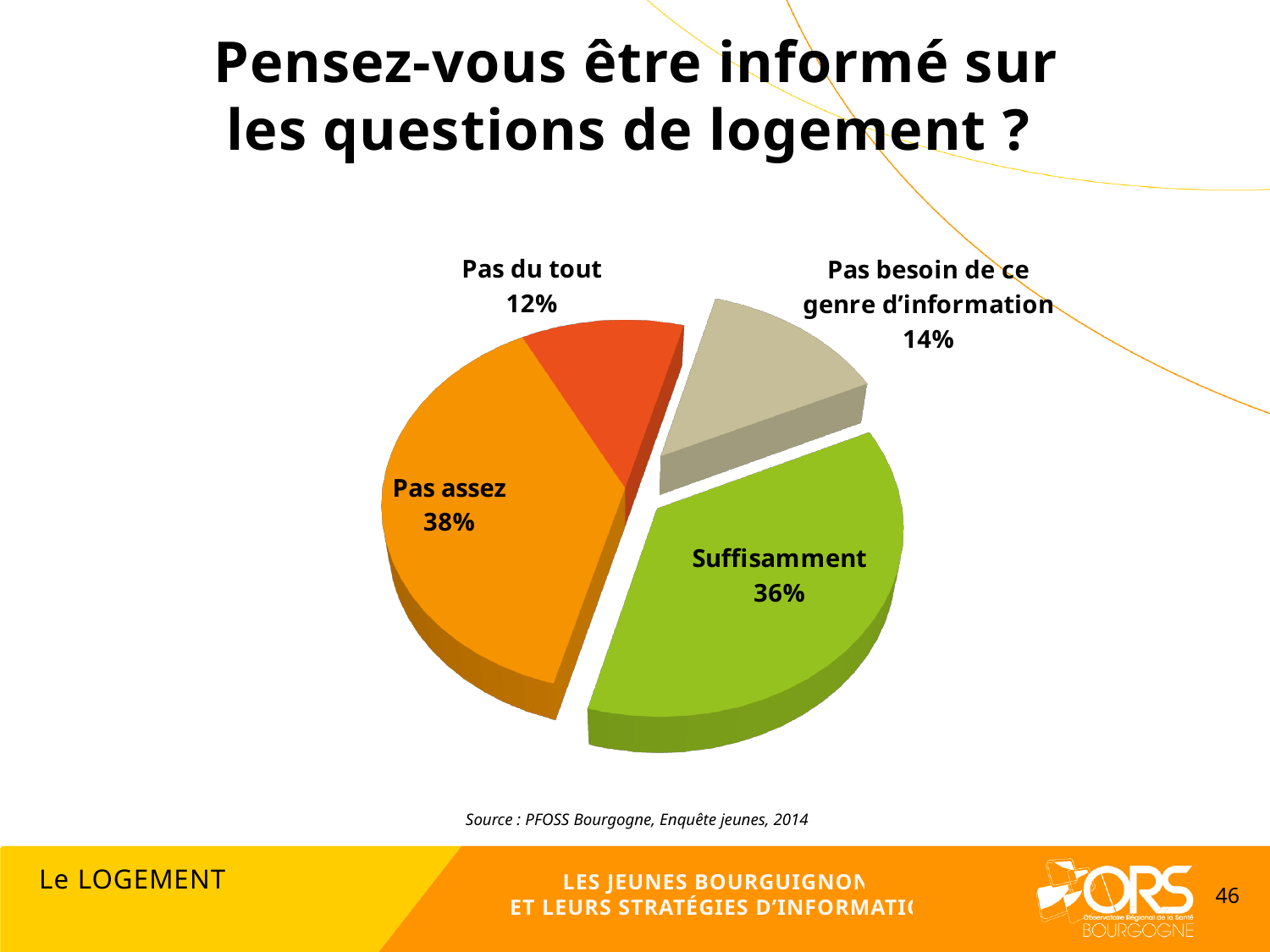
Which response has the smallest share of the pie? Pas du tout How many slices does the pie chart have? 4 What share of respondents answered "Suffisamment"? 36% What share of respondents answered "Pas du tout"? 12% What is the source cited below the chart? PFOSS Bourgogne, Enquête jeunes, 2014 Which is larger: the share for "Pas besoin de ce genre d'information" or the share for "Pas du tout"? Pas besoin de ce genre d'information Which response has the largest share of the pie? Pas assez What type of chart is shown on the slide? Pie chart What share of respondents answered "Pas assez"? 38% What share of respondents answered "Pas besoin de ce genre d'information"? 14% What is the difference in percentage points between "Pas assez" and "Suffisamment"? 2 percentage points What is the difference in percentage points between "Pas besoin de ce genre d'information" and "Pas du tout"? 2 percentage points